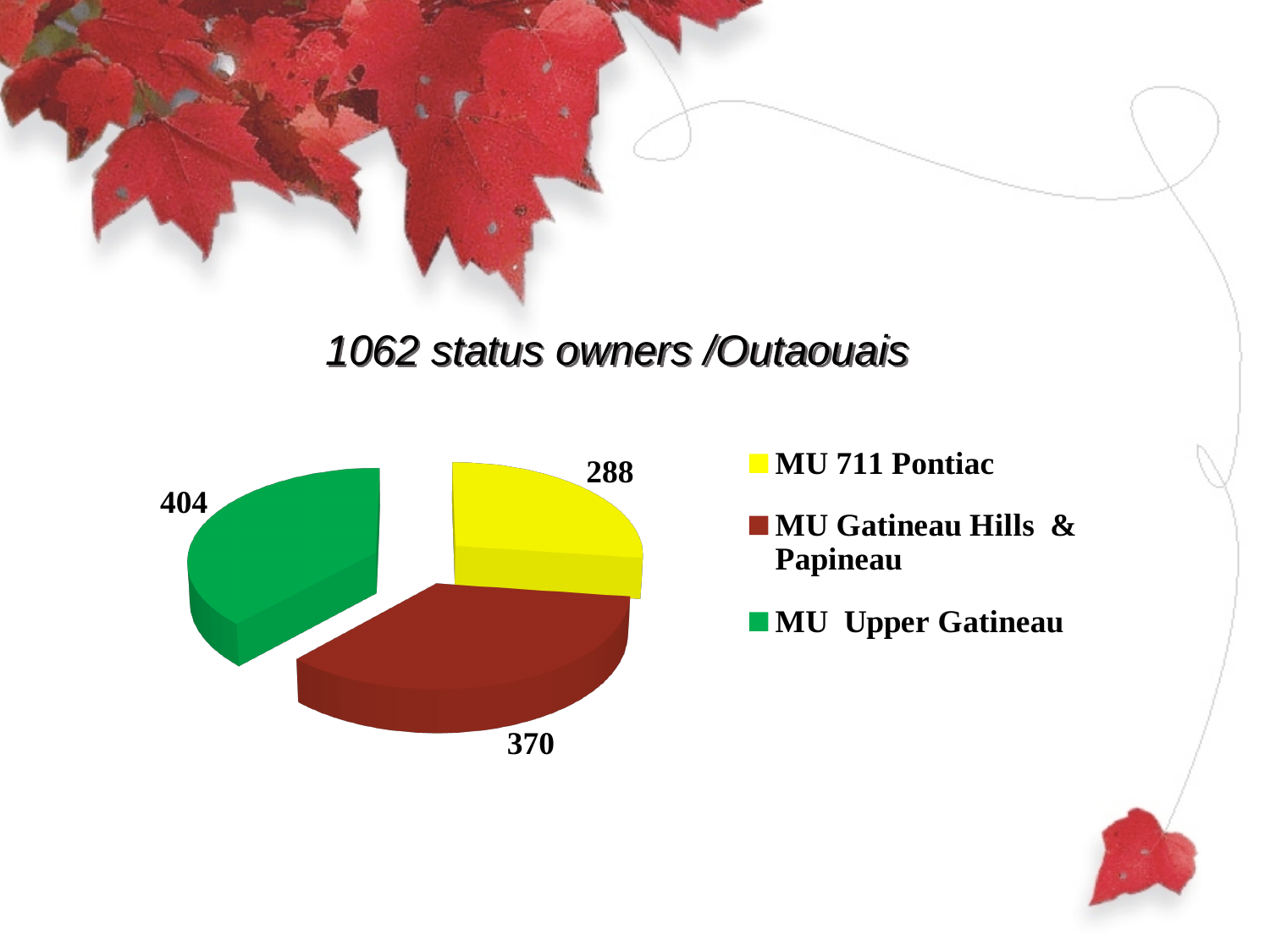
What is the value for MU Upper Gatineau? 404 What is the value for MU Gatineau Hills & Papineau? 370 What colour is the slice for MU 711 Pontiac? Yellow What type of chart is shown on the slide? Pie chart Which category has the smallest slice of the pie? MU 711 Pontiac What is the difference between the values for MU Upper Gatineau and MU 711 Pontiac? 116 What is the value for MU 711 Pontiac? 288 What is the difference between the values for MU Gatineau Hills & Papineau and MU 711 Pontiac? 82 How many slices does the pie chart have? 3 What is the total of all three slices in the pie chart? 1062 Which is larger, the value for MU Gatineau Hills & Papineau or the value for MU Upper Gatineau? MU Upper Gatineau Which category has the largest slice of the pie? MU Upper Gatineau